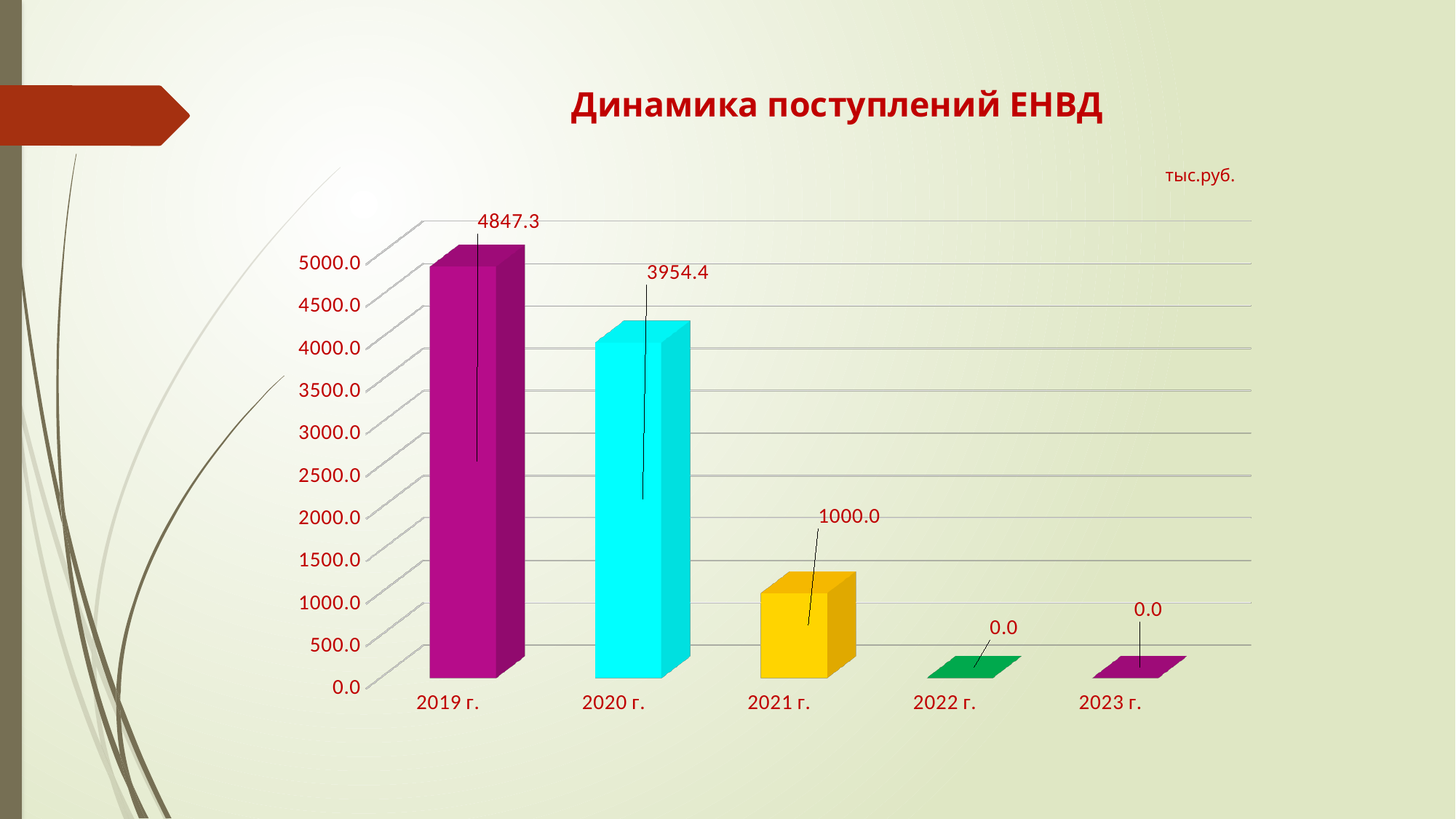
What is the value for 2022 г.? 0.0 Which year has the highest value? 2019 г. What is the value for 2021 г.? 1000.0 What is the difference between the values for 2019 г. and 2020 г.? 892.9 How many years are shown on the x axis? 5 Which is larger, the value for 2020 г. or the value for 2021 г.? 2020 г. What is the value for 2019 г.? 4847.3 What is the difference between the values for 2020 г. and 2021 г.? 2954.4 What kind of chart is this? bar chart What is the value for 2020 г.? 3954.4 What is the title of the chart? Динамика поступлений ЕНВД Do the values rise or fall from 2019 г. to 2023 г.? fall